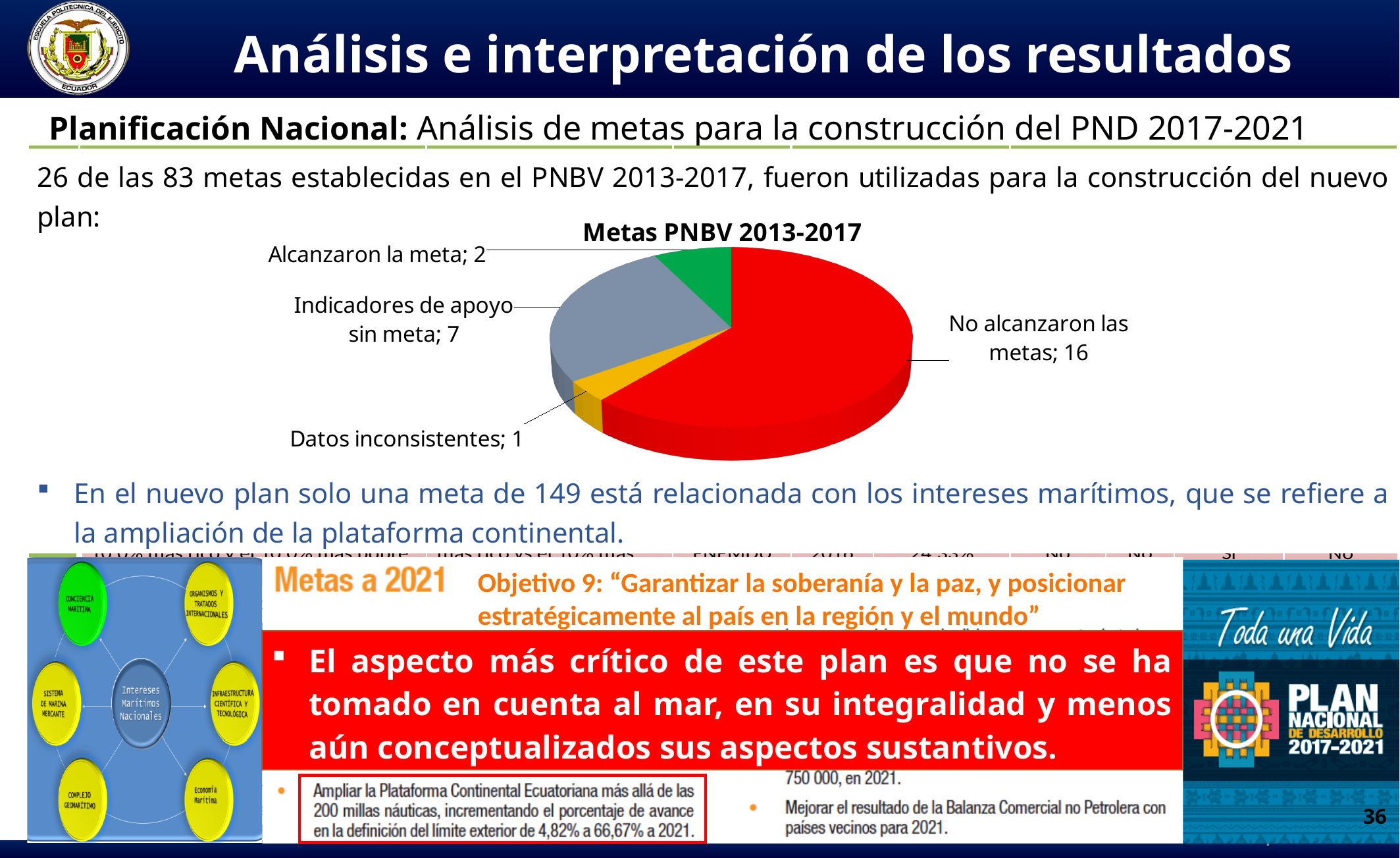
What is the value for "Indicadores de apoyo sin meta" in the pie chart? 7 What is the value for "Alcanzaron la meta" in the pie chart? 2 What is the value for "Datos inconsistentes" in the pie chart? 1 Which category has the largest slice in the pie chart? No alcanzaron las metas Which is larger in the pie chart: "Alcanzaron la meta" or "Indicadores de apoyo sin meta"? Indicadores de apoyo sin meta Which category has the smallest slice in the pie chart? Datos inconsistentes How many slices does the pie chart "Metas PNBV 2013-2017" have? 4 What is the difference between "No alcanzaron las metas" and "Indicadores de apoyo sin meta" in the pie chart? 9 What is the value for "No alcanzaron las metas" in the pie chart? 16 What is the title of the pie chart? Metas PNBV 2013-2017 What colour is the "No alcanzaron las metas" slice in the pie chart? red What kind of chart is shown under the title "Metas PNBV 2013-2017"? pie chart